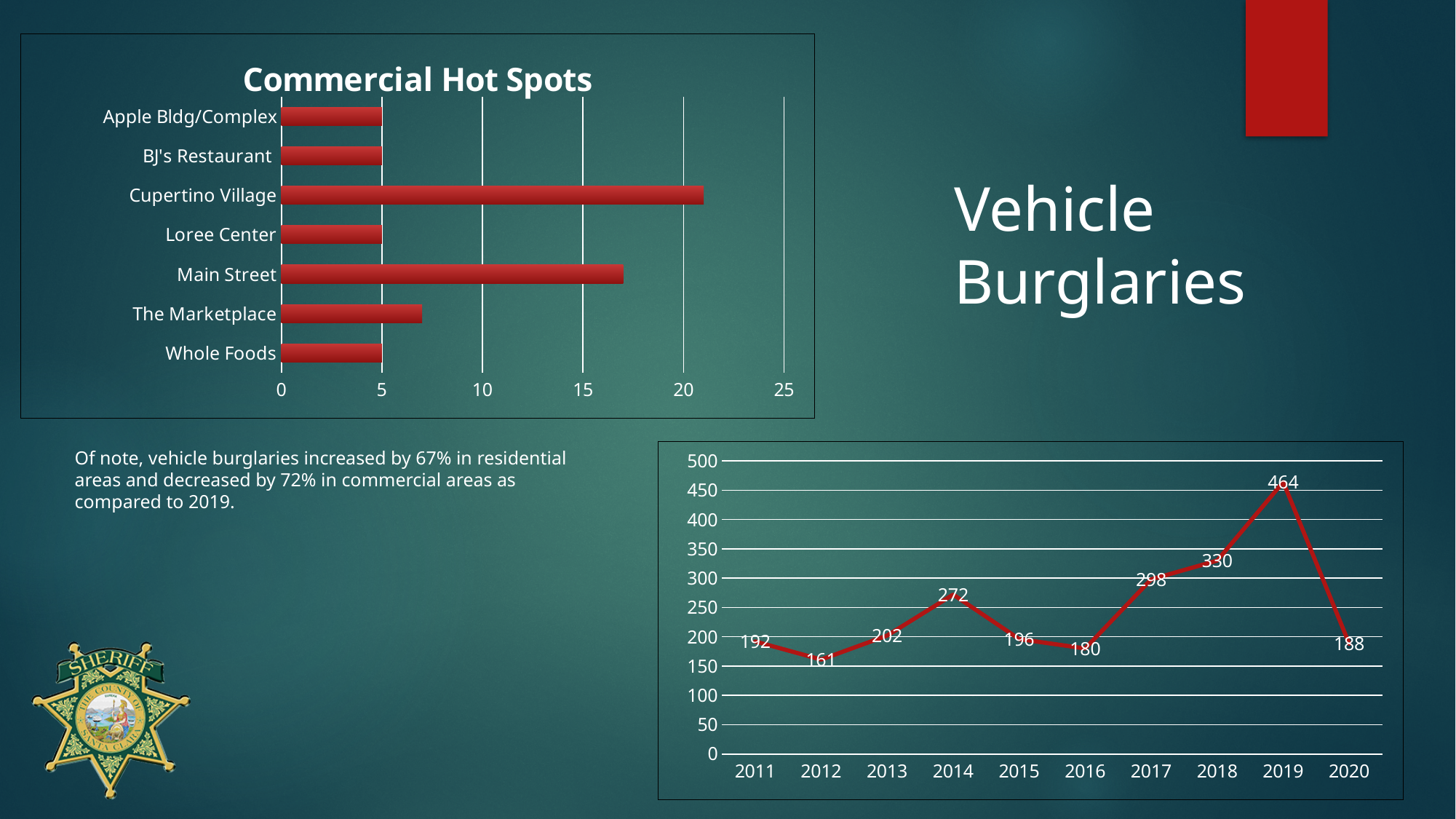
In the Commercial Hot Spots chart, is the value for Cupertino Village greater or less than 20? greater In the Commercial Hot Spots chart, is the value for Main Street greater or less than 15? greater In the Commercial Hot Spots chart, which location has the highest value? Cupertino Village In the line chart at the bottom right, do the values rise or fall from 2016 to 2019? rise What kind of chart is the Commercial Hot Spots chart? bar chart In the line chart at the bottom right, how many years are plotted? 10 In the Commercial Hot Spots chart, how many locations are listed? 7 In the Commercial Hot Spots chart, what is the value for Whole Foods? 5 In the line chart at the bottom right, what is the value for 2019? 464 In the line chart at the bottom right, what is the difference between the values for 2019 and 2020? 276 In the Commercial Hot Spots chart, which is larger, the value for Main Street or The Marketplace? Main Street In the line chart at the bottom right, which year has the lowest value? 2012